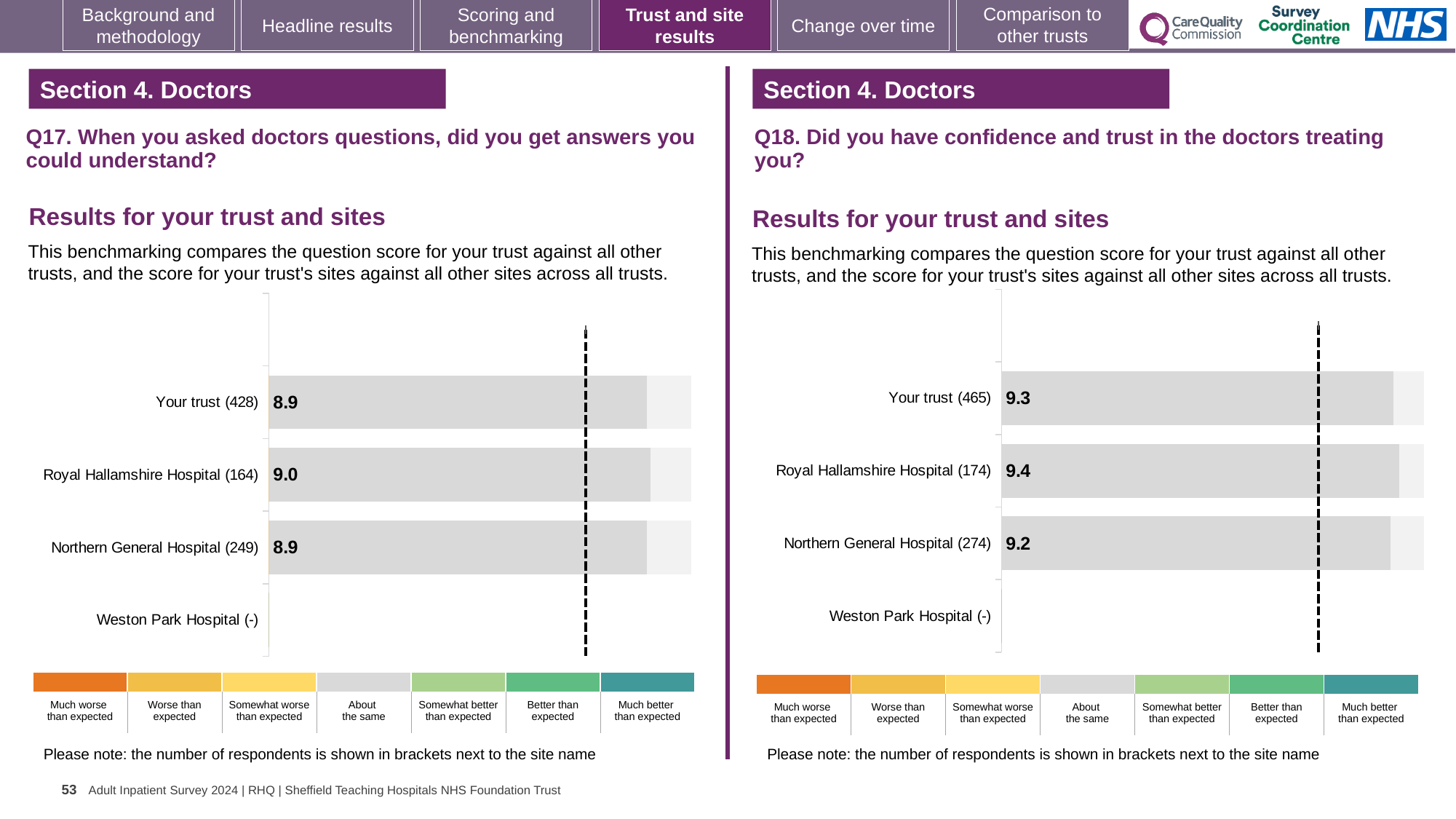
In the Q17 chart on the left, how many respondents are shown in brackets for Northern General Hospital? 249 What kind of chart is used for the Q18 results on the right? Bar chart In the Q18 chart on the right, what is the score for Northern General Hospital? 9.2 In the Q17 chart on the left, what is the score for Your trust? 8.9 In the Q18 chart on the right, which site has the lowest score among those with a score shown? Northern General Hospital In the Q17 chart on the left, what is the difference between the scores for Royal Hallamshire Hospital and Northern General Hospital? 0.1 In the Q17 chart on the left, which has the higher score: Royal Hallamshire Hospital or Northern General Hospital? Royal Hallamshire Hospital In the Q18 chart on the right, what is the difference between the scores for Royal Hallamshire Hospital and Northern General Hospital? 0.2 In the Q18 chart on the right, which site has the highest score? Royal Hallamshire Hospital In the Q18 chart on the right, what is the score for Your trust? 9.3 In the Q17 chart on the left, what is the score for Royal Hallamshire Hospital? 9.0 How many sites or rows are listed in the Q17 chart on the left? 4